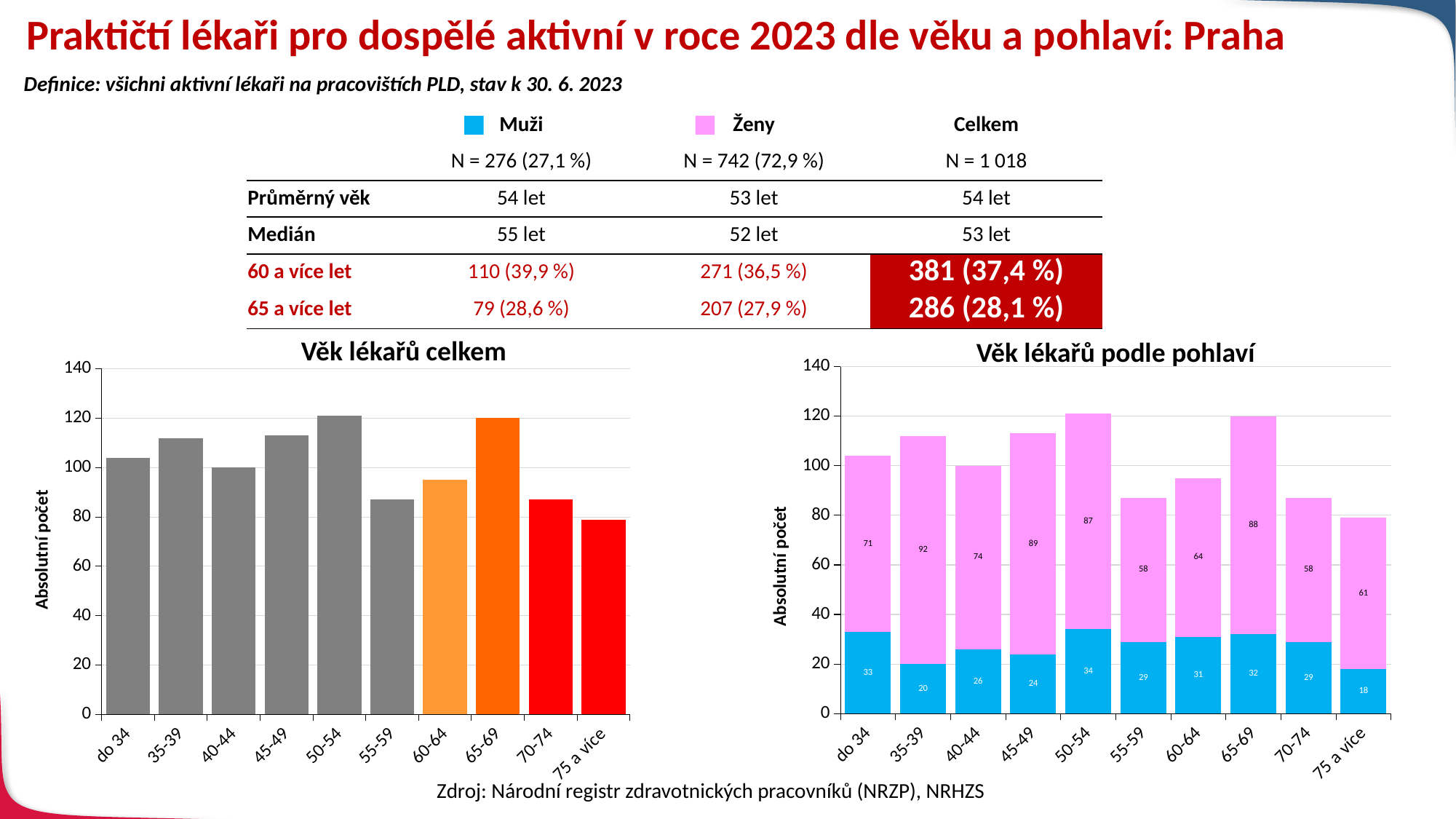
In the chart 'Věk lékařů celkem', which is larger: the value for '35-39' or for '40-44'? 35-39 In the chart 'Věk lékařů podle pohlaví', which age group has the highest value for Ženy? 35-39 In the chart 'Věk lékařů podle pohlaví', what is the value for Muži in the 'do 34' age group? 33 In the chart 'Věk lékařů celkem', is the value for '55-59' greater or less than 100? less In the chart 'Věk lékařů podle pohlaví', what is the total of the stacked bar for the '50-54' age group? 121 In the chart 'Věk lékařů podle pohlaví', which is larger: the Muži value for '50-54' or for '35-39'? 50-54 In the chart 'Věk lékařů podle pohlaví', what is the value for Ženy in the '35-39' age group? 92 How many age groups are shown on the x axis of the chart 'Věk lékařů celkem'? 10 In the chart 'Věk lékařů podle pohlaví', how much larger is the Ženy value than the Muži value in the '65-69' age group? 56 In the chart 'Věk lékařů podle pohlaví', which age group has the lowest value for Muži? 75 a více How many series does the legend of the chart 'Věk lékařů podle pohlaví' list? 2 What kind of chart is 'Věk lékařů celkem'? bar chart